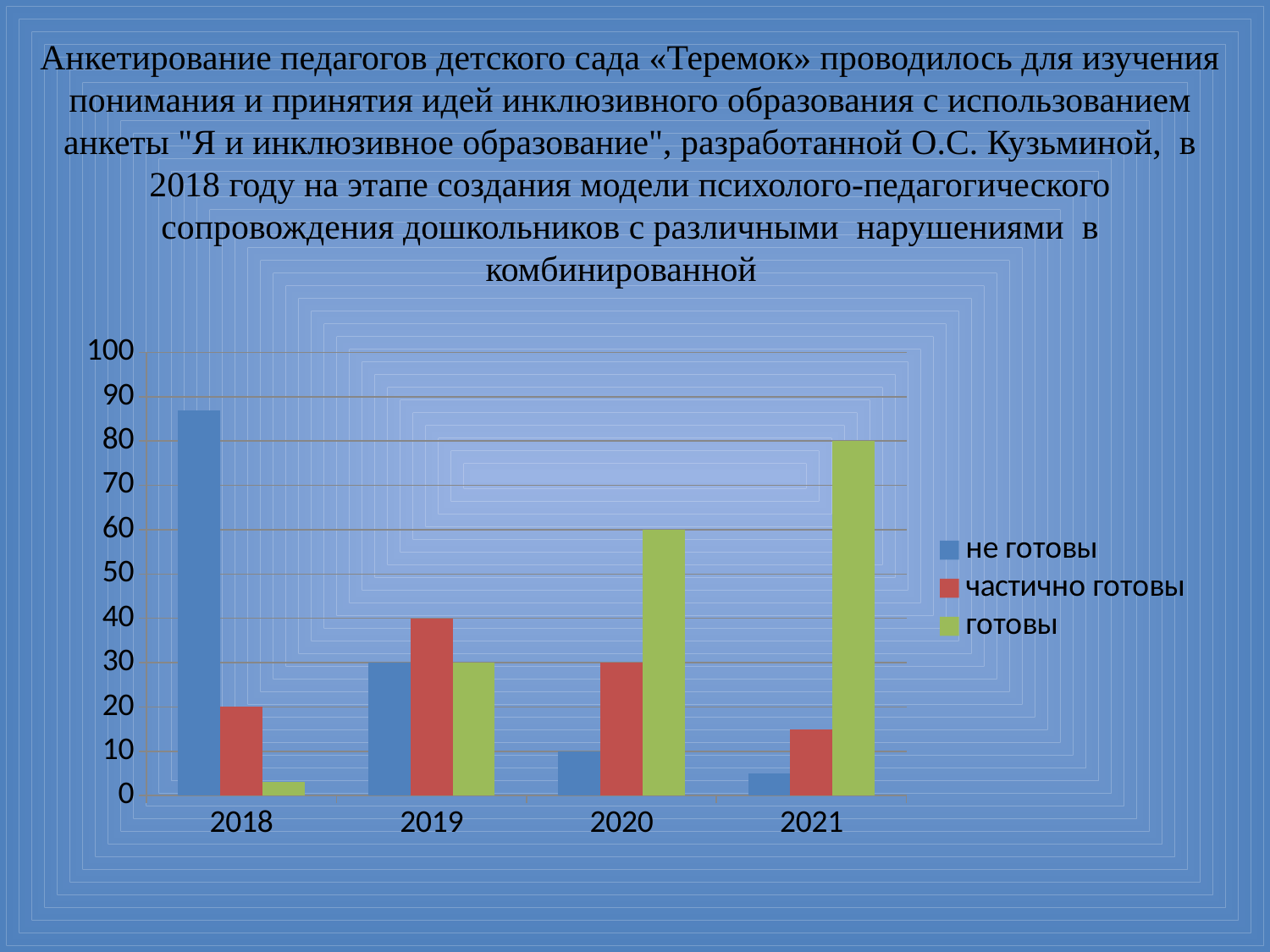
What kind of chart is shown on the slide? bar chart What is the value for "готовы" in 2020? 60 In which year is the value for "не готовы" lowest? 2021 Is the value for "не готовы" in 2018 greater or less than 80? greater In which year is the value for "готовы" highest? 2021 What is the value for "частично готовы" in 2019? 40 Does the value for "не готовы" rise or fall from 2018 to 2021? fall What is the value for "не готовы" in 2020? 10 Is the value for "не готовы" in 2021 greater or less than 10? less What is the value for "готовы" in 2021? 80 How many years are shown on the x axis? 4 How many series does the legend list? 3